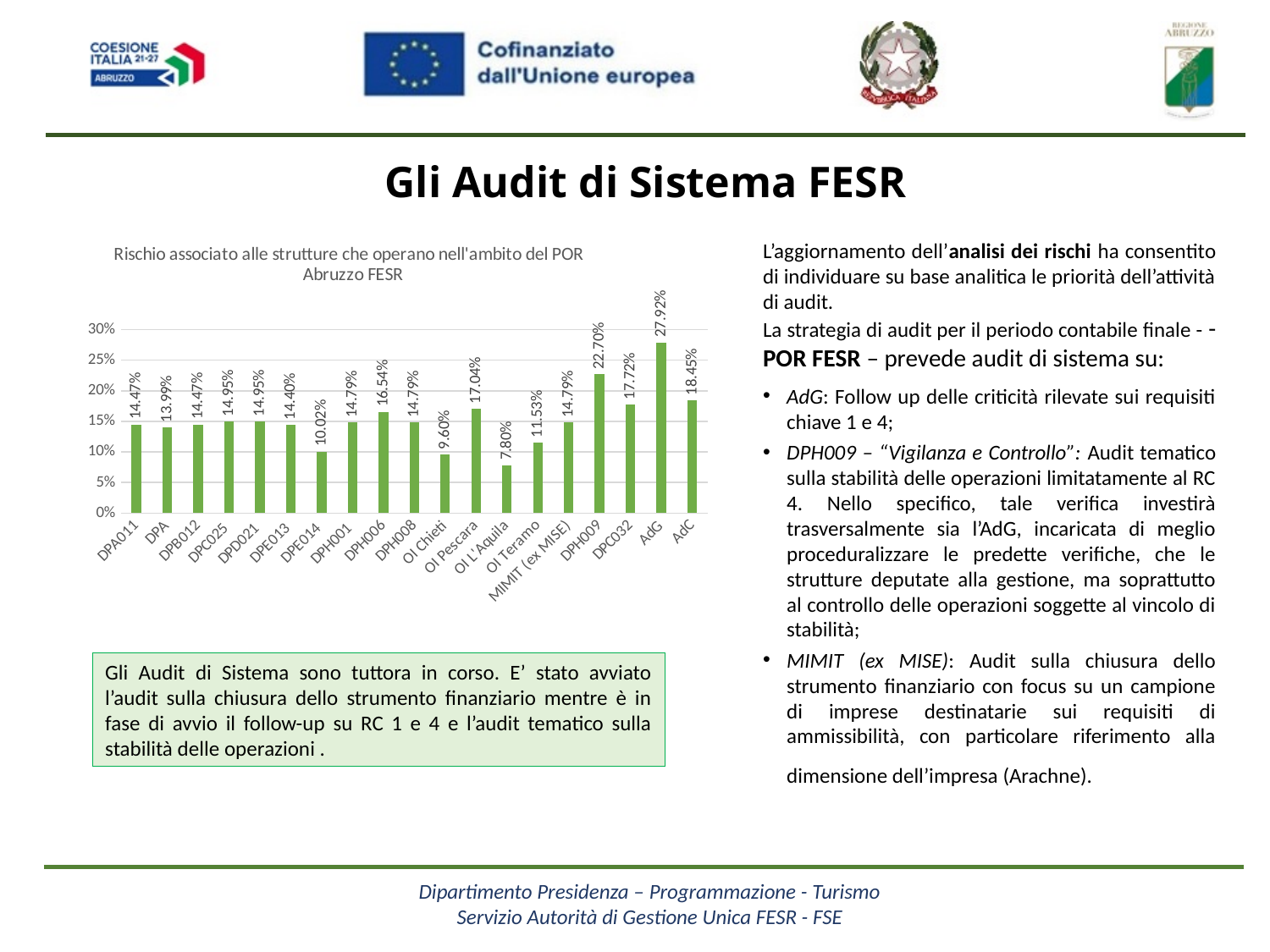
Is the value for DPH009 greater or less than 20%? greater What is the value for MIMIT (ex MISE) in the chart? 14.79% What kind of chart is shown on the slide? Bar chart Which category has the highest value in the chart? AdG What is the value for AdG in the chart? 27.92% Which has a larger value, DPH006 or DPH001? DPH006 What is the difference between the values for AdG and DPH009? 5.22 percentage points What is the difference between the values for OI Pescara and OI Chieti? 7.44 percentage points What is the value for OI Chieti in the chart? 9.60% Which category has the lowest value in the chart? OI L'Aquila What is the title of the chart? Rischio associato alle strutture che operano nell'ambito del POR Abruzzo FESR How many categories are shown on the x axis of the chart? 19